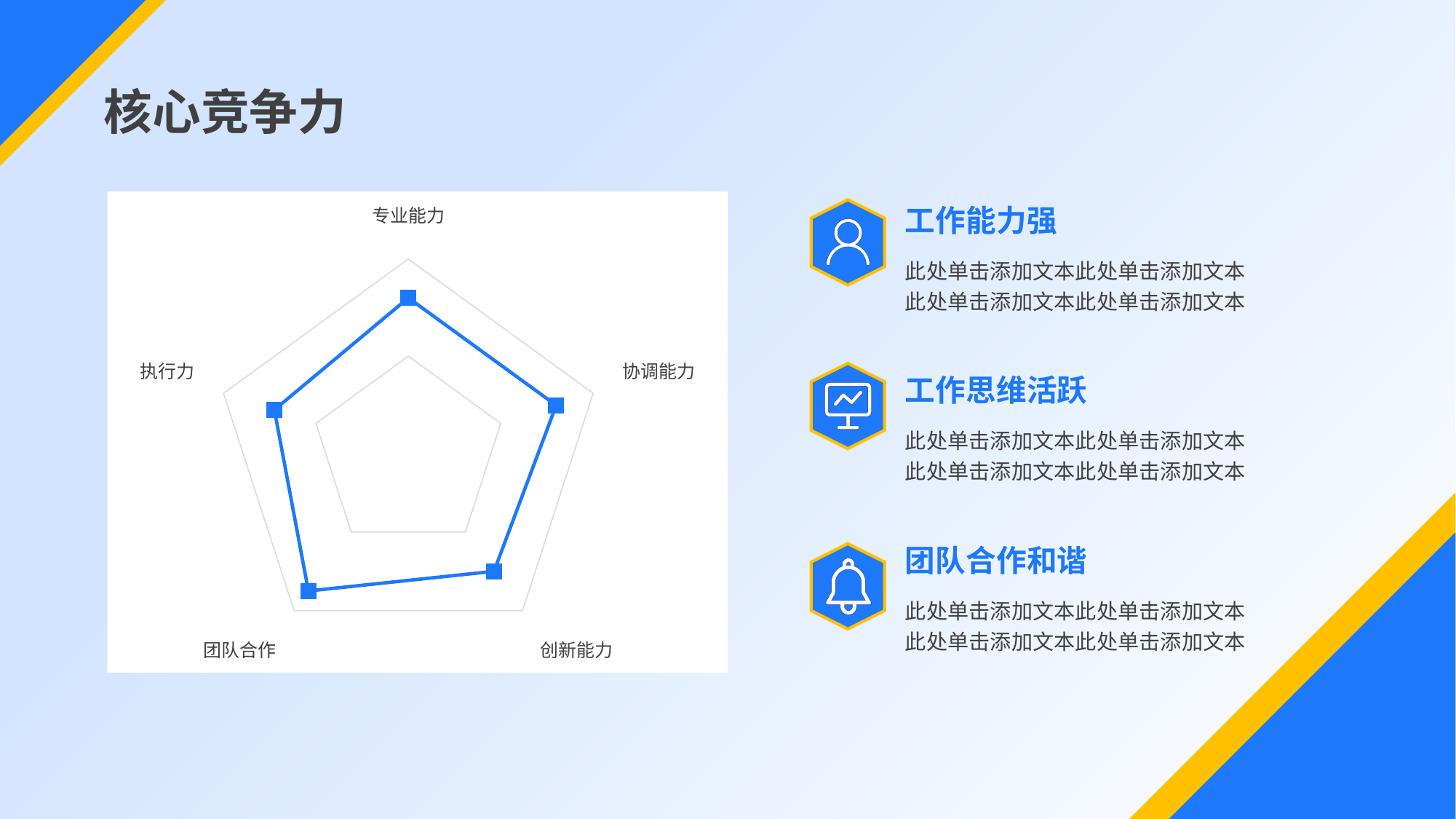
How many categories (axes) does the radar chart have? 5 What is the title of the slide containing the radar chart? 核心竞争力 Which has the larger value on the radar chart, 团队合作 or 执行力? 团队合作 What kind of chart is shown on the slide? Radar chart How many data series are plotted on the radar chart? 1 Which category label appears at the top of the radar chart? 专业能力